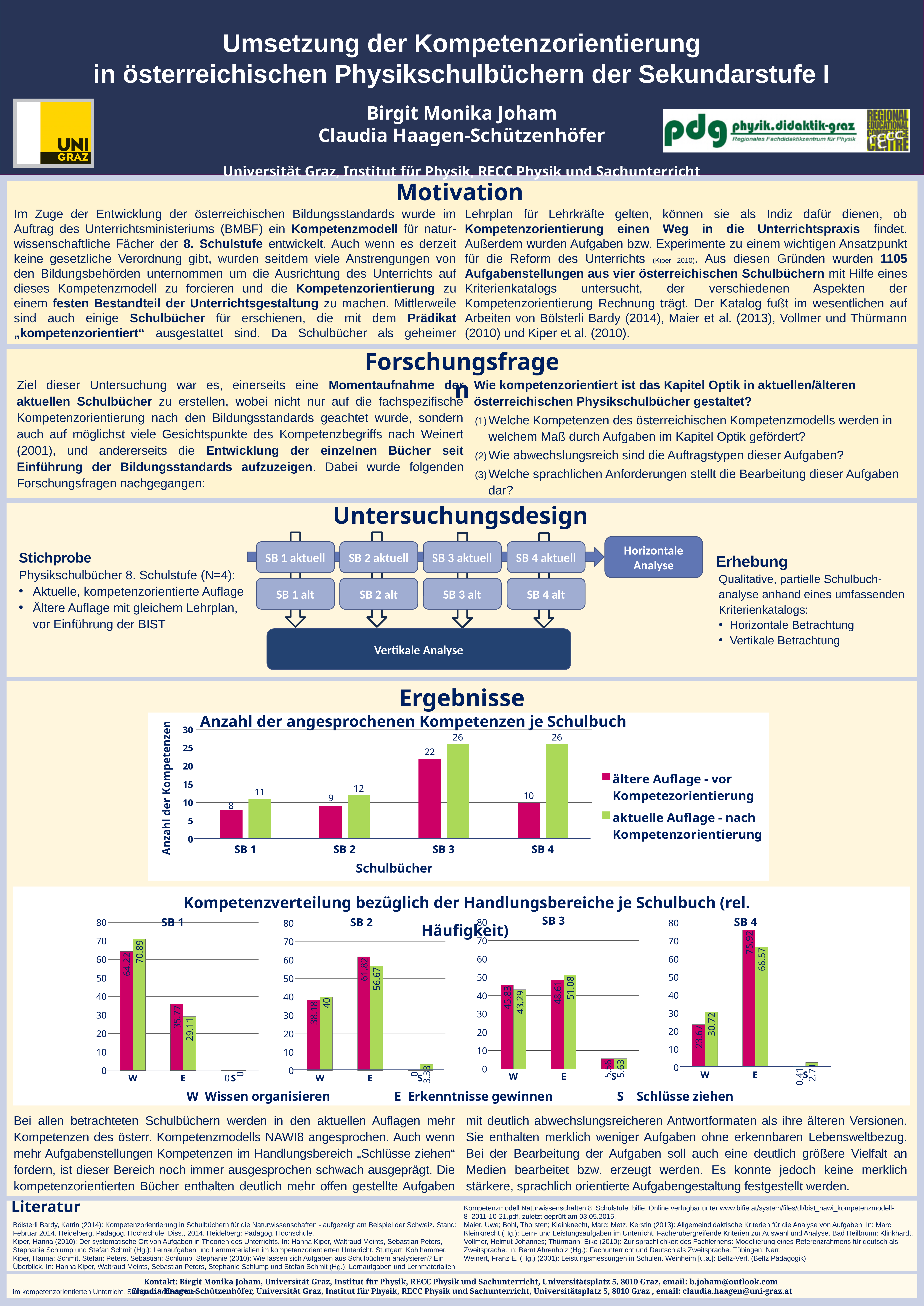
In the chart 'Anzahl der angesprochenen Kompetenzen je Schulbuch', how many series does the legend list? 2 In the chart 'Anzahl der angesprochenen Kompetenzen je Schulbuch', what is the difference between the aktuelle Auflage and ältere Auflage values for SB 4? 16 In the SB 4 chart under 'Kompetenzverteilung bezüglich der Handlungsbereiche je Schulbuch', what is the value for E in the ältere Auflage (magenta) series? 75.92 In the chart 'Anzahl der angesprochenen Kompetenzen je Schulbuch', which Schulbuch has the highest value in the 'ältere Auflage' series? SB 3 In the chart 'Anzahl der angesprochenen Kompetenzen je Schulbuch', how many Schulbücher are shown on the x axis? 4 In the chart 'Anzahl der angesprochenen Kompetenzen je Schulbuch', what is the value for SB 3 in the 'aktuelle Auflage - nach Kompetenzorientierung' series? 26 In the SB 1 chart under 'Kompetenzverteilung bezüglich der Handlungsbereiche je Schulbuch', what is the value for W in the aktuelle Auflage (green) series? 70.89 In the SB 2 chart under 'Kompetenzverteilung bezüglich der Handlungsbereiche je Schulbuch', which is larger for the ältere Auflage series: W or E? E What kind of chart is 'Anzahl der angesprochenen Kompetenzen je Schulbuch'? bar chart In the SB 3 chart under 'Kompetenzverteilung bezüglich der Handlungsbereiche je Schulbuch', what is the value for S in the aktuelle Auflage (green) series? 5.63 In the chart 'Anzahl der angesprochenen Kompetenzen je Schulbuch', what is the value for SB 1 in the 'ältere Auflage - vor Kompetezorientierung' series? 8 In the chart 'Anzahl der angesprochenen Kompetenzen je Schulbuch', which Schulbuch has the lowest value in the 'aktuelle Auflage' series? SB 1